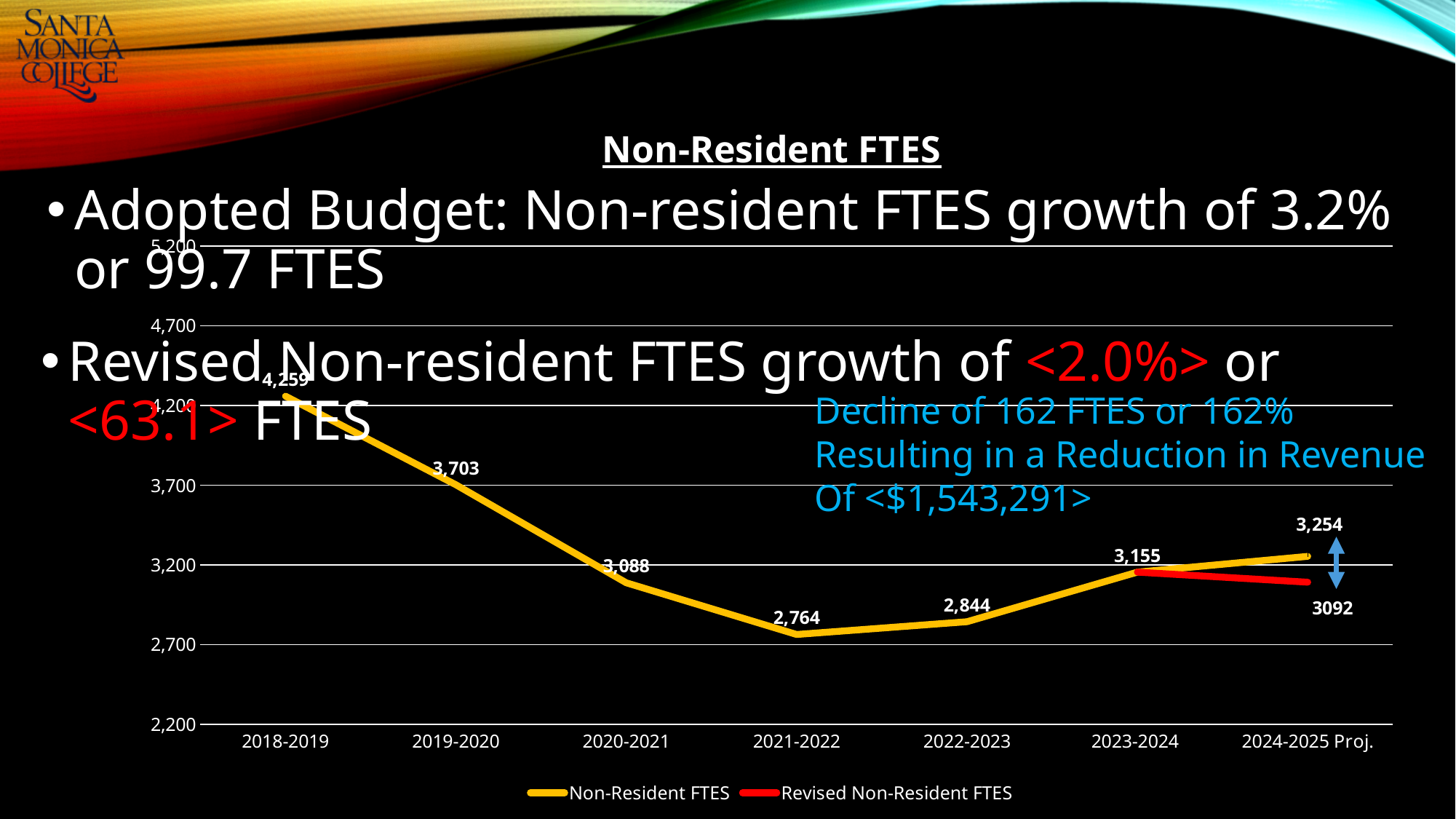
How many years are shown on the x axis of the chart? 7 What is the Revised Non-Resident FTES value for 2024-2025 Proj.? 3092 How many series does the chart legend list? 2 What is the Non-Resident FTES value for 2019-2020? 3,703 What is the Non-Resident FTES value for 2021-2022? 2,764 Which year has the lowest Non-Resident FTES value? 2021-2022 What is the difference between the Non-Resident FTES values for 2019-2020 and 2020-2021? 615 Which year has the highest Non-Resident FTES value? 2018-2019 Which is larger, the Non-Resident FTES value for 2022-2023 or for 2023-2024? 2023-2024 What is the Non-Resident FTES value for 2023-2024? 3,155 What type of chart is shown on the slide? line chart Is the Non-Resident FTES value for 2020-2021 greater or less than 3,200? less